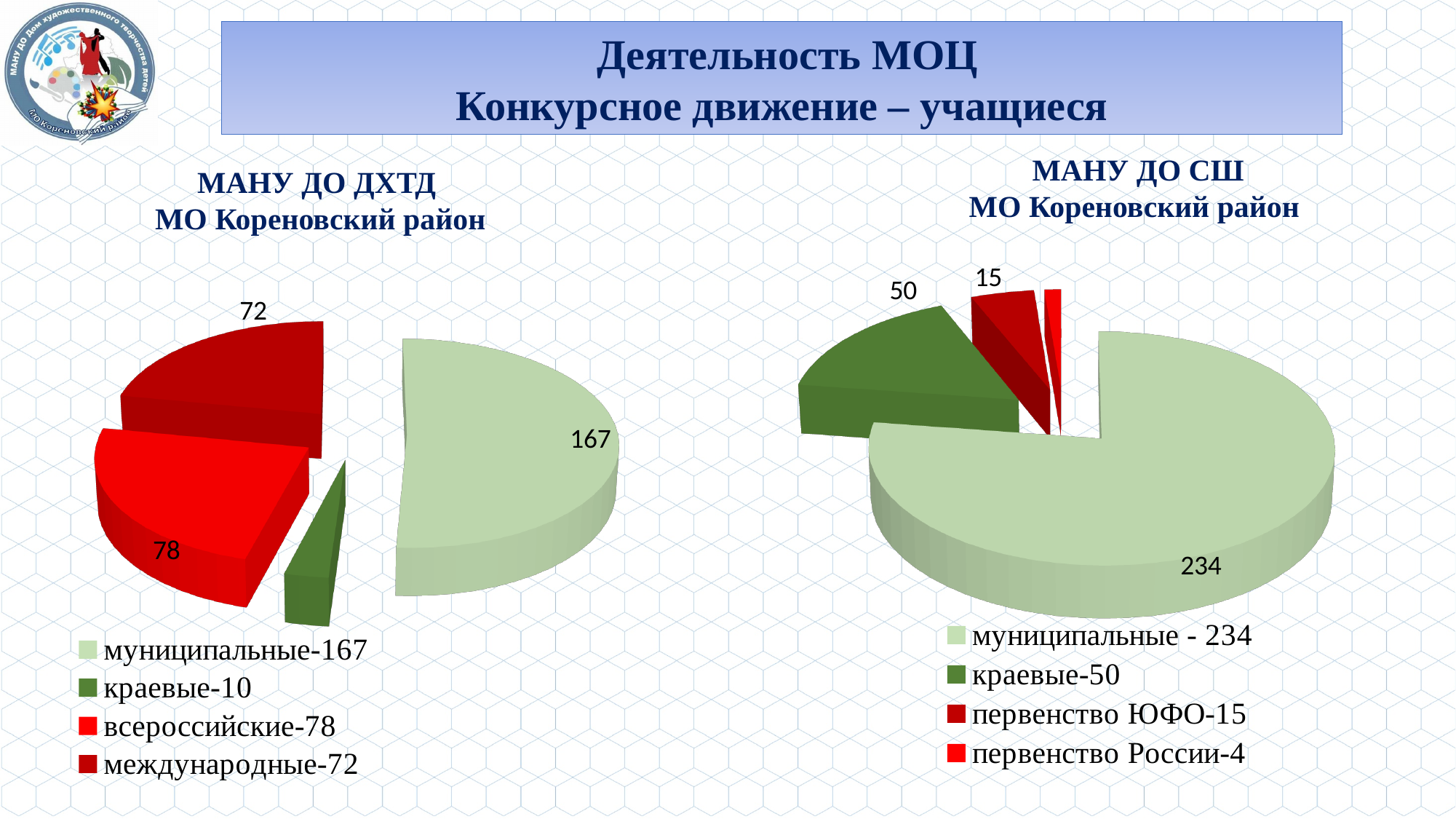
In the right chart (МАНУ ДО СШ), what is the difference between муниципальные and краевые? 184 In the right chart (МАНУ ДО СШ), what is the value for первенство России? 4 In the left chart (МАНУ ДО ДХТД), how many categories does the legend list? 4 In the left chart (МАНУ ДО ДХТД), what is the value for муниципальные? 167 In the left chart (МАНУ ДО ДХТД), what is the value for всероссийские? 78 Which chart has the larger value for муниципальные: the left chart (МАНУ ДО ДХТД) or the right chart (МАНУ ДО СШ)? the right chart (МАНУ ДО СШ) What type of chart is used on the left chart titled 'МАНУ ДО ДХТД МО Кореновский район'? pie chart In the right chart (МАНУ ДО СШ), which category has the largest value? муниципальные In the left chart (МАНУ ДО ДХТД), what is the difference between всероссийские and международные? 6 In the left chart (МАНУ ДО ДХТД), which category has the smallest value? краевые In the right chart (МАНУ ДО СШ), which is larger: краевые or первенство ЮФО? краевые In the right chart (МАНУ ДО СШ), what is the value for краевые? 50